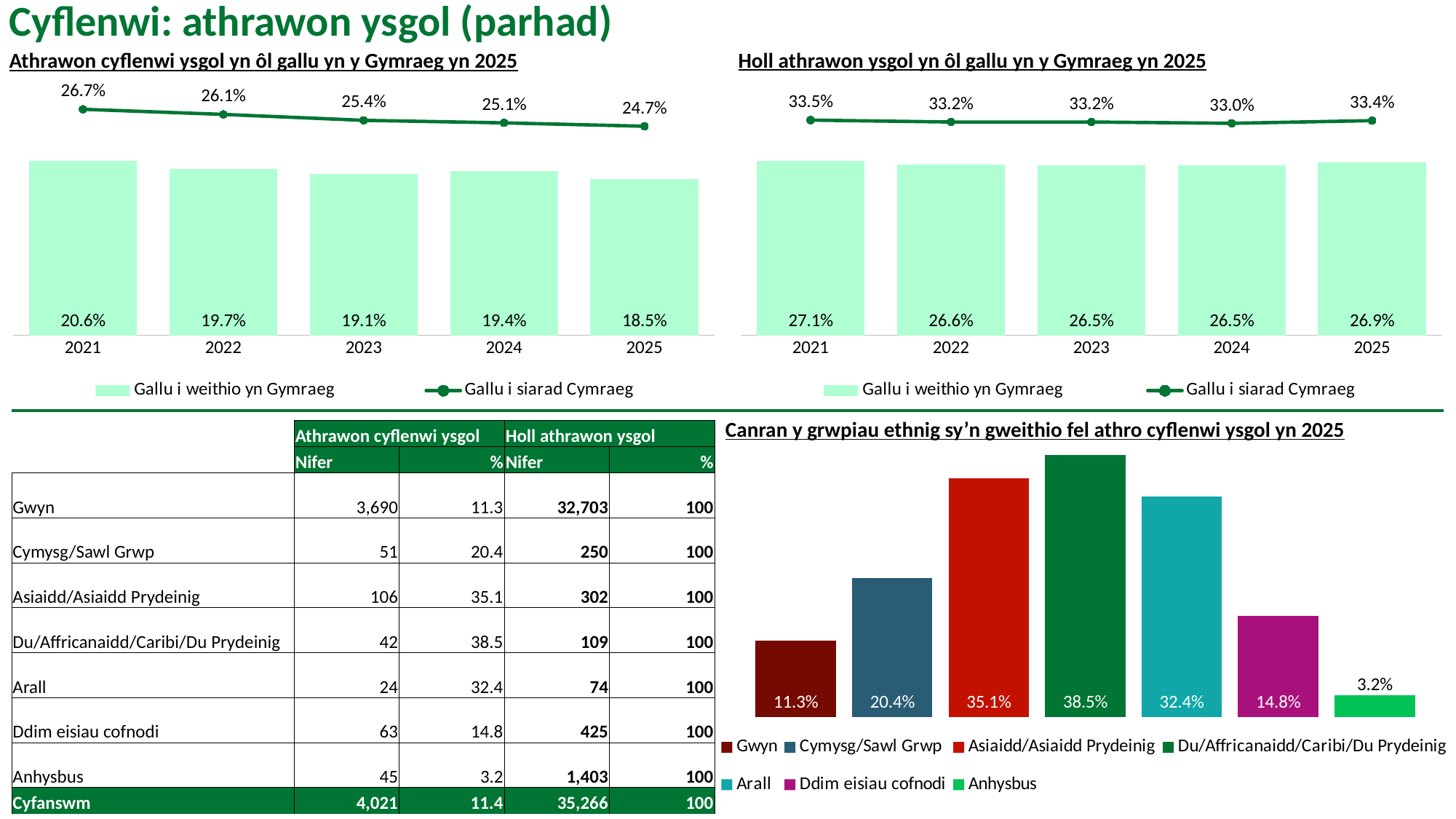
What kind of chart is the one titled 'Canran y grwpiau ethnig sy'n gweithio fel athro cyflenwi ysgol yn 2025'? bar chart In the chart titled 'Athrawon cyflenwi ysgol yn ôl gallu yn y Gymraeg yn 2025', what is the difference between the 'Gallu i siarad Cymraeg' values for 2021 and 2025? 2.0% In the chart titled 'Holl athrawon ysgol yn ôl gallu yn y Gymraeg yn 2025', what is the value of 'Gallu i weithio yn Gymraeg' for 2021? 27.1% In the chart titled 'Athrawon cyflenwi ysgol yn ôl gallu yn y Gymraeg yn 2025', does the 'Gallu i siarad Cymraeg' line rise or fall from 2021 to 2025? fall In the chart titled 'Holl athrawon ysgol yn ôl gallu yn y Gymraeg yn 2025', which year has the lowest 'Gallu i siarad Cymraeg' value? 2024 In the chart titled 'Canran y grwpiau ethnig sy'n gweithio fel athro cyflenwi ysgol yn 2025', which is larger, the value for 'Gwyn' or the value for 'Ddim eisiau cofnodi'? Ddim eisiau cofnodi In the chart titled 'Canran y grwpiau ethnig sy'n gweithio fel athro cyflenwi ysgol yn 2025', which group has the highest value? Du/Affricanaidd/Caribi/Du Prydeinig In the chart titled 'Holl athrawon ysgol yn ôl gallu yn y Gymraeg yn 2025', how many series does the legend list? 2 In the chart titled 'Athrawon cyflenwi ysgol yn ôl gallu yn y Gymraeg yn 2025', what is the value of 'Gallu i weithio yn Gymraeg' for 2025? 18.5% In the chart titled 'Athrawon cyflenwi ysgol yn ôl gallu yn y Gymraeg yn 2025', what is the value of 'Gallu i siarad Cymraeg' for 2021? 26.7% In the chart titled 'Canran y grwpiau ethnig sy'n gweithio fel athro cyflenwi ysgol yn 2025', what is the value for 'Arall'? 32.4% In the chart titled 'Holl athrawon ysgol yn ôl gallu yn y Gymraeg yn 2025', how many years are shown on the x axis? 5